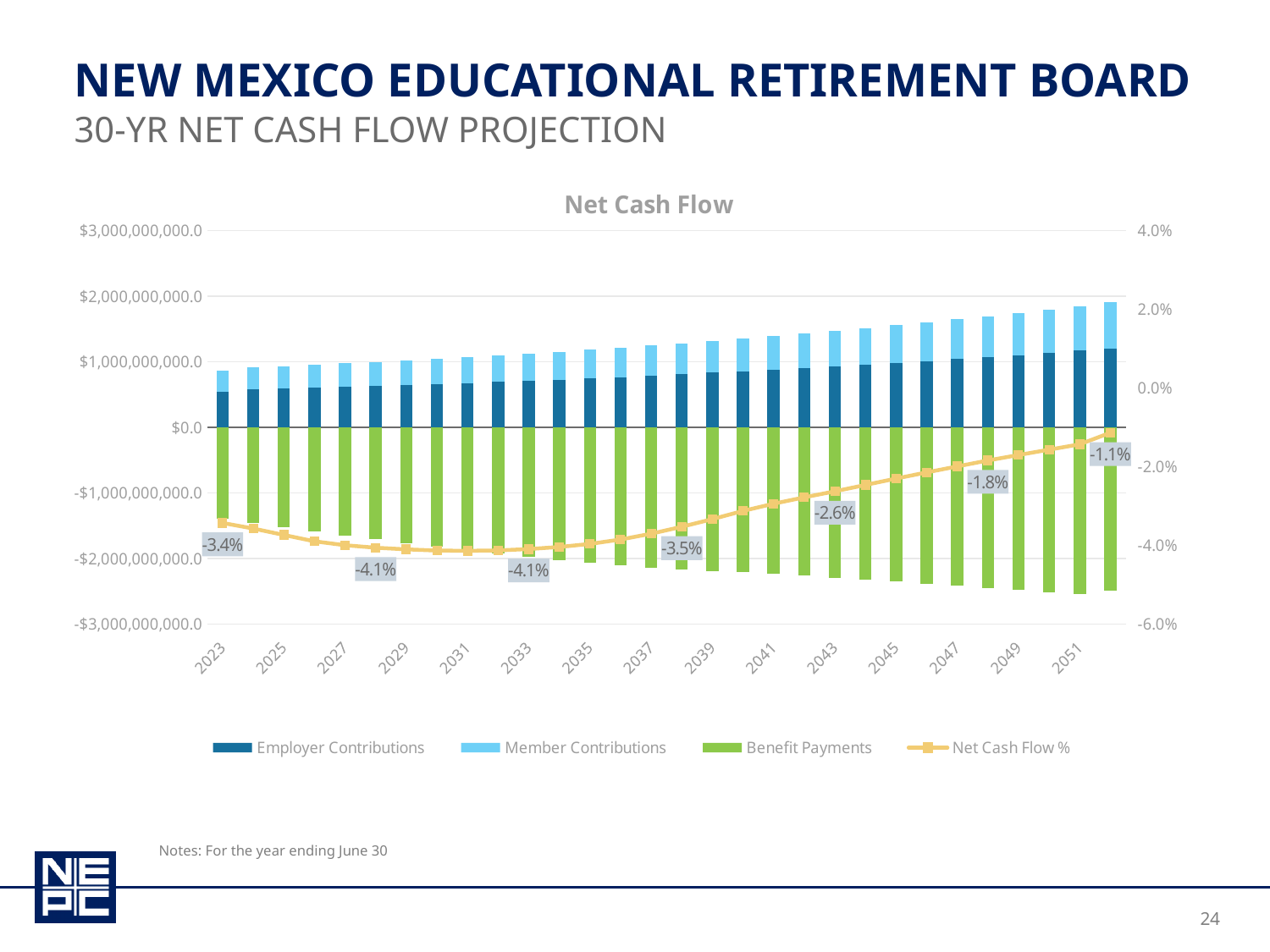
What is the Net Cash Flow % value labeled for 2023? -3.4% How many data labels are printed on the Net Cash Flow % line? 7 Is the total of Employer and Member Contributions in 2023 greater or less than $1,000,000,000.0? less What is the lowest Net Cash Flow % value labeled on the line? -4.1% How many series does the legend list? 4 What is the title of the chart? Net Cash Flow What kind of chart is shown on the slide? A combination chart with stacked bars and a line In 2023, which is larger: Employer Contributions or Member Contributions? Employer Contributions What is the difference between the first labeled Net Cash Flow % (-3.4%) and the last labeled value (-1.1%)? 2.3 percentage points What is the last Net Cash Flow % value labeled at the right end of the line? -1.1% Which series is plotted as a line rather than bars? Net Cash Flow % From the -4.1% low point around 2033 to the end of the projection, does the Net Cash Flow % line rise or fall? Rise